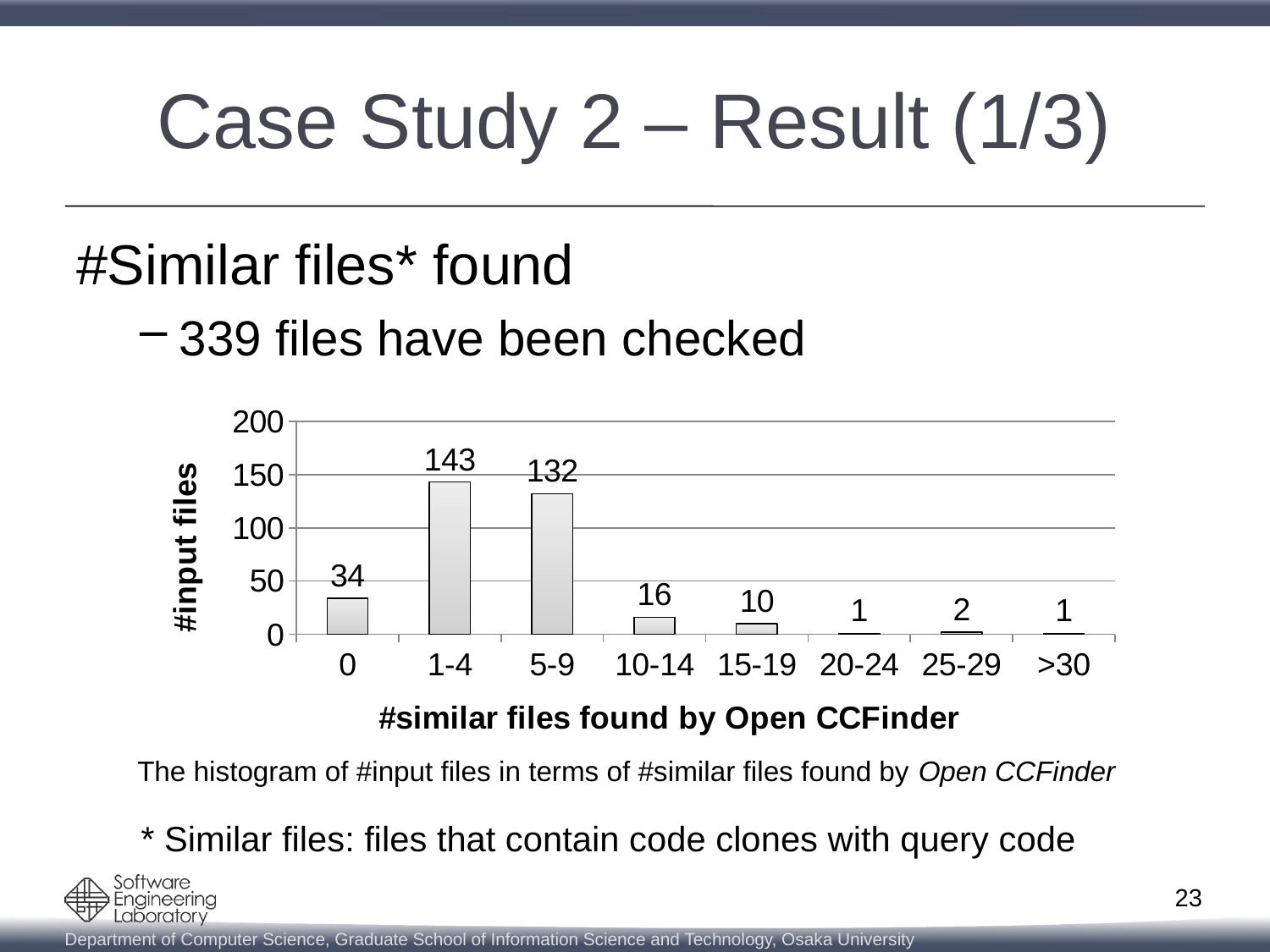
What is the x-axis title of the chart? #similar files found by Open CCFinder Which category has the highest number of input files? 1-4 Is the value for the '5-9' category greater or less than 100? greater What kind of chart is shown on the slide? bar chart What is the number of input files for the '0' category? 34 What is the difference in input files between the '1-4' and '5-9' categories? 11 How many categories are shown on the x axis? 8 What is the difference in input files between the '0' category and the '10-14' category? 18 Which has more input files, the '10-14' category or the '15-19' category? 10-14 What is the y-axis title of the chart? #input files What is the number of input files for the '1-4' category? 143 What is the number of input files for the '15-19' category? 10